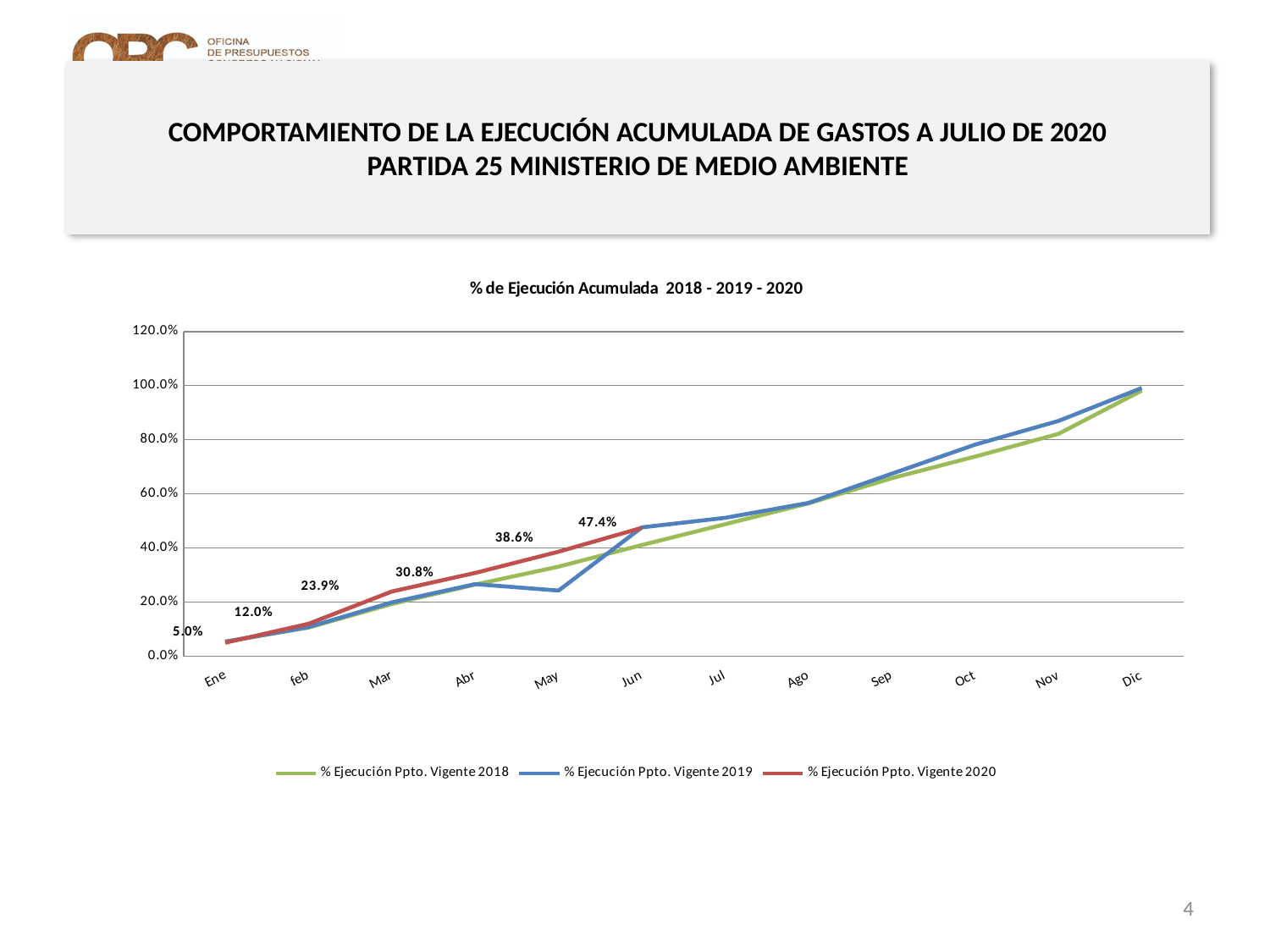
What is the value of % Ejecución Ppto. Vigente 2020 in Mar? 23.9% What is the value of % Ejecución Ppto. Vigente 2020 in Ene? 5.0% What is the value of % Ejecución Ppto. Vigente 2020 in Jun? 47.4% What is the value of % Ejecución Ppto. Vigente 2020 in May? 38.6% Does the % Ejecución Ppto. Vigente 2020 line rise or fall from Ene to Jun? rise What is the difference between the 2020 values for feb and Ene? 7.0% What type of chart is shown on the slide? line chart How many series does the legend list? 3 Is the value for % Ejecución Ppto. Vigente 2019 in Nov greater or less than 80.0%? greater How many months are shown on the x axis? 12 What is the title of the chart? % de Ejecución Acumulada 2018 - 2019 - 2020 What is the difference between the 2020 values for Jun and May? 8.8%